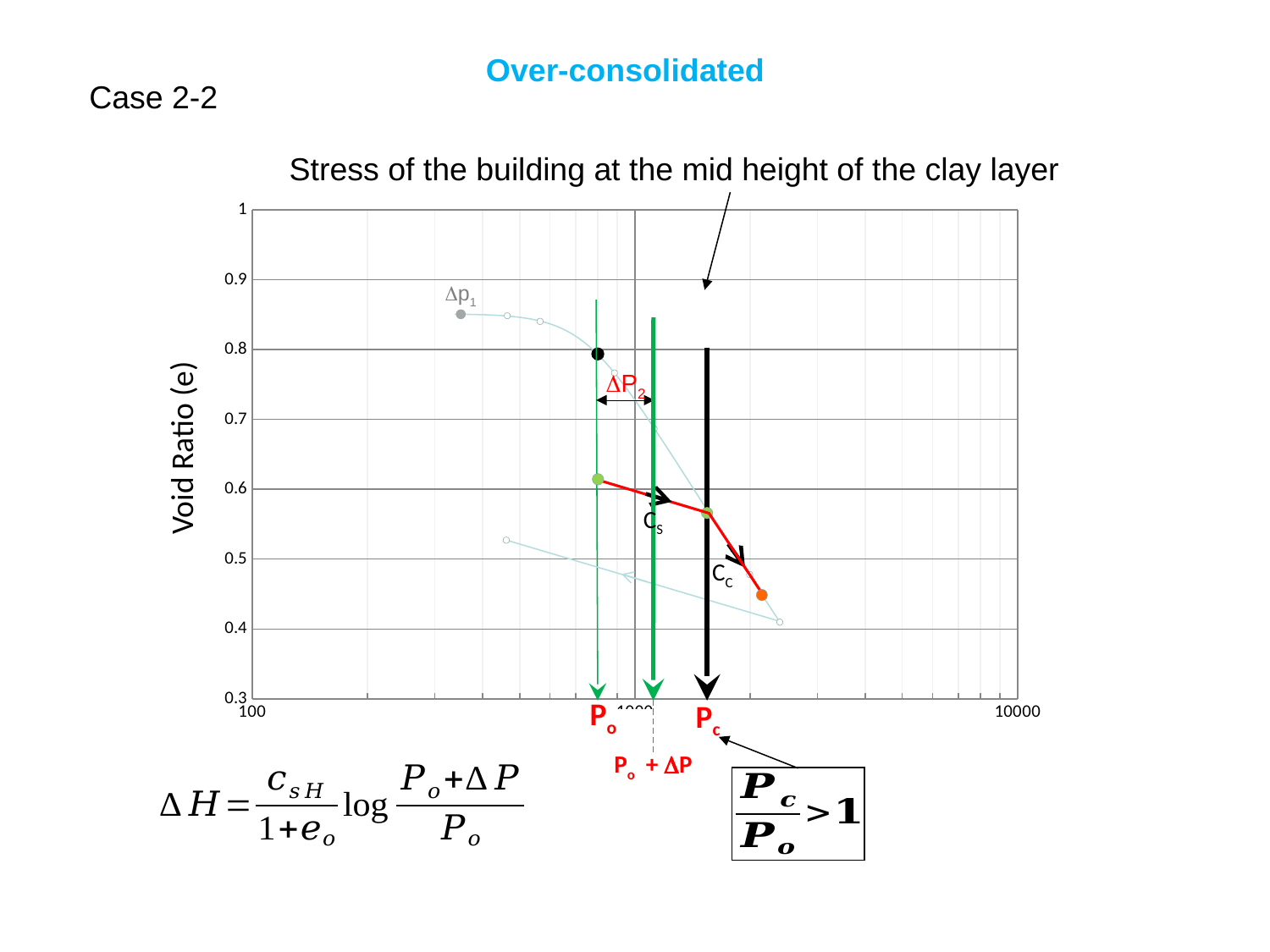
Is the void ratio of the orange point at the end of the red Cc line greater or less than 0.5? less What is the lowest value shown on the horizontal axis? 100 Along the red line from Po to Pc and beyond, does the void ratio rise or fall as stress increases? fall What is the highest value shown on the horizontal axis? 10000 Is the void ratio of the black point on the Po line greater or less than 0.7? greater What is the title of the vertical axis? Void Ratio (e) What kind of chart is shown on the slide? line chart Which point has the higher void ratio, the point labelled Δp1 or the orange point at the end of the Cc line? Δp1 Is the void ratio of the green point on the Po line greater or less than 0.7? less Which labelled stress is larger on the horizontal axis, Po or Pc? Pc What is the lowest value shown on the vertical axis? 0.3